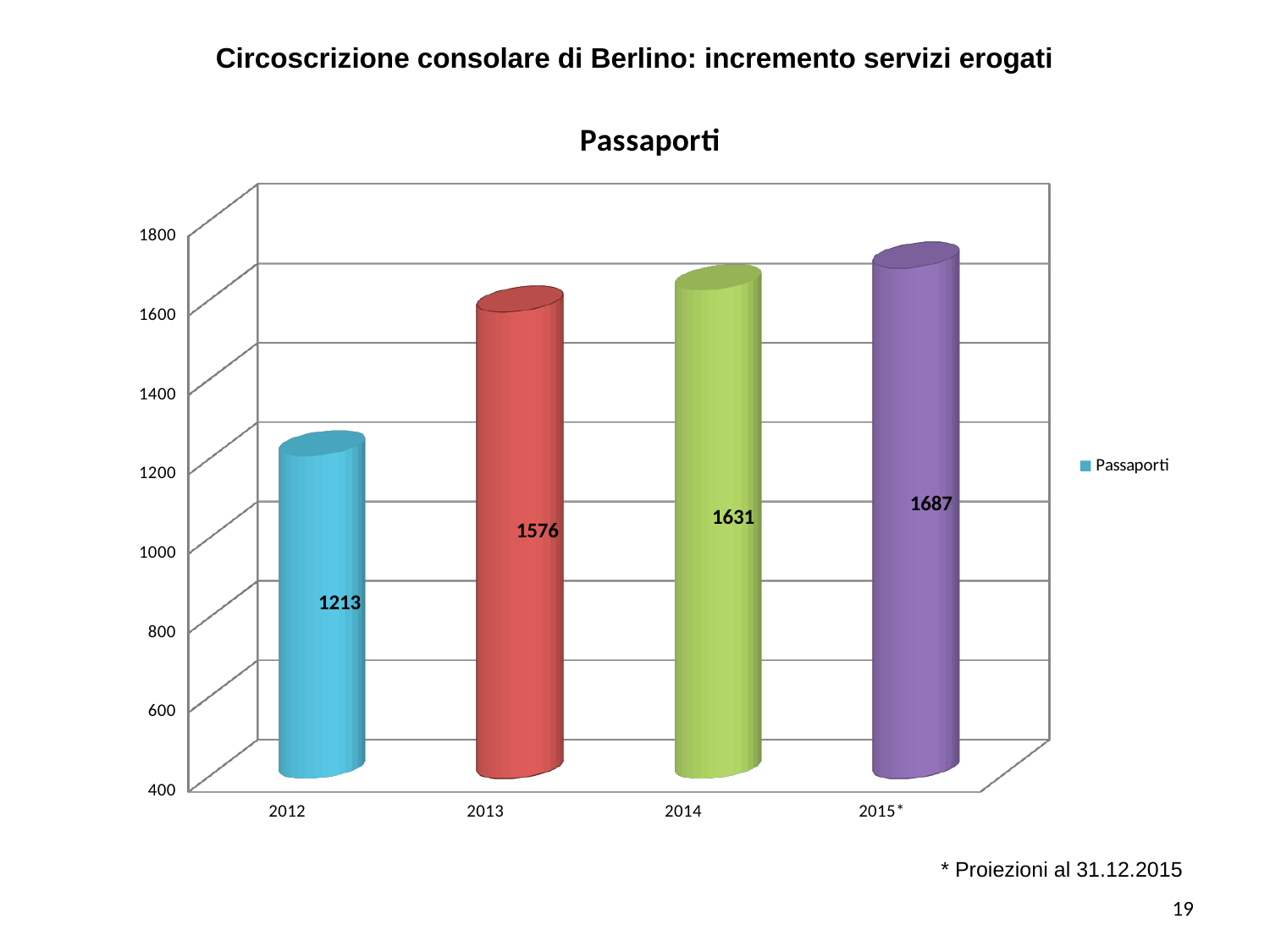
What is the value for 2012 in the Passaporti chart? 1213 How many years are shown on the x axis of the chart? 4 What is the value for 2015* in the Passaporti chart? 1687 Which year has the highest value in the Passaporti chart? 2015* Which year has the lowest value in the Passaporti chart? 2012 Which is larger, the value for 2013 or the value for 2012? 2013 What is the value for 2013 in the Passaporti chart? 1576 Do the values rise or fall from 2012 to 2015*? rise What is the difference between the values for 2015* and 2012? 474 What is the value for 2014 in the Passaporti chart? 1631 What kind of chart is shown on the slide? bar chart What is the difference between the values for 2014 and 2013? 55